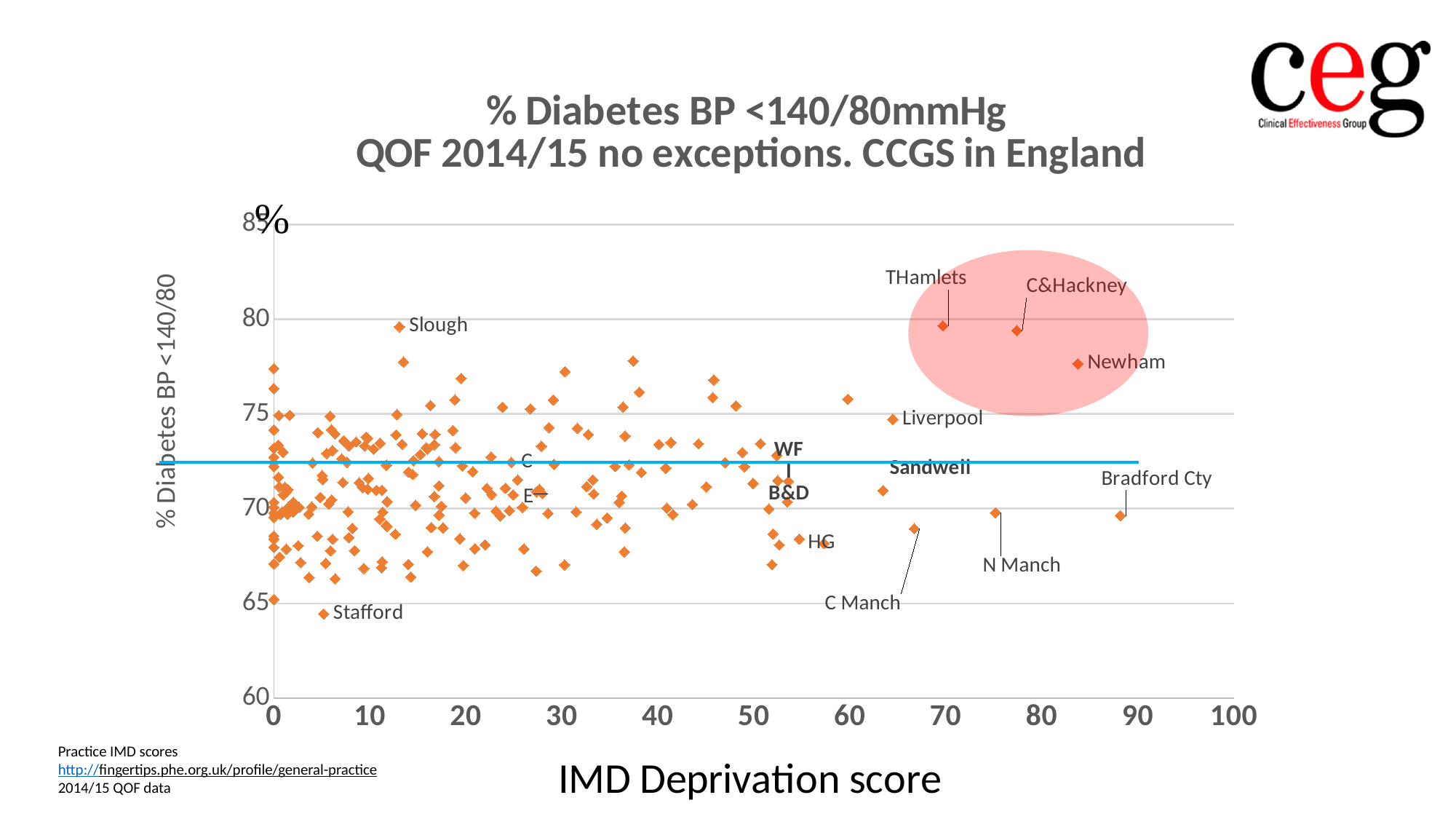
Is the IMD Deprivation score for Bradford Cty greater or less than 80? greater Is the value for Stafford greater or less than 70? less Is the value for Newham greater or less than 75? greater Which has the higher % Diabetes BP <140/80 value, Slough or Stafford? Slough Which labelled CCG has the lowest % Diabetes BP <140/80 value? Stafford What is the label of the x axis? IMD Deprivation score What is the title of the chart? % Diabetes BP <140/80mmHg QOF 2014/15 no exceptions. CCGS in England Which has the higher % Diabetes BP <140/80 value, Newham or Bradford Cty? Newham What kind of chart is shown on the slide? scatter chart